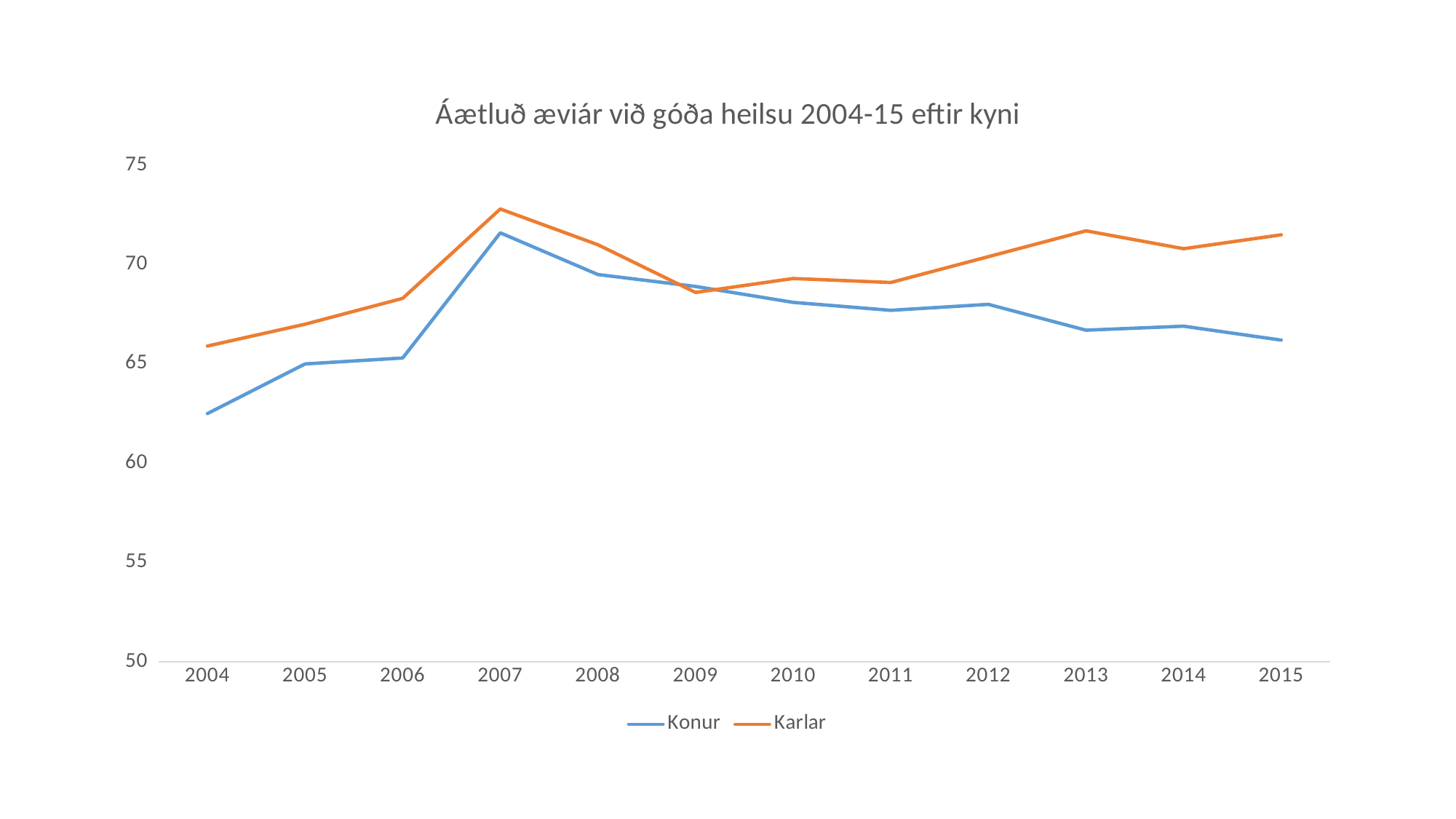
Is the value for Konur in 2012 greater or less than 70? less In which year does the Konur series reach its highest value? 2007 Does the Konur series rise or fall from 2007 to 2015? fall How many series does the legend list? 2 How many years are plotted along the x axis? 12 What kind of chart is shown on the slide? line chart Is the value for Karlar in 2007 greater or less than 70? greater What is the title of the chart? Áætluð æviár við góða heilsu 2004-15 eftir kyni In 2015, which series has the higher value, Konur or Karlar? Karlar Is the value for Konur in 2004 greater or less than 65? less In which year does the Karlar series reach its highest value? 2007 In which year is the Konur series at its lowest value? 2004